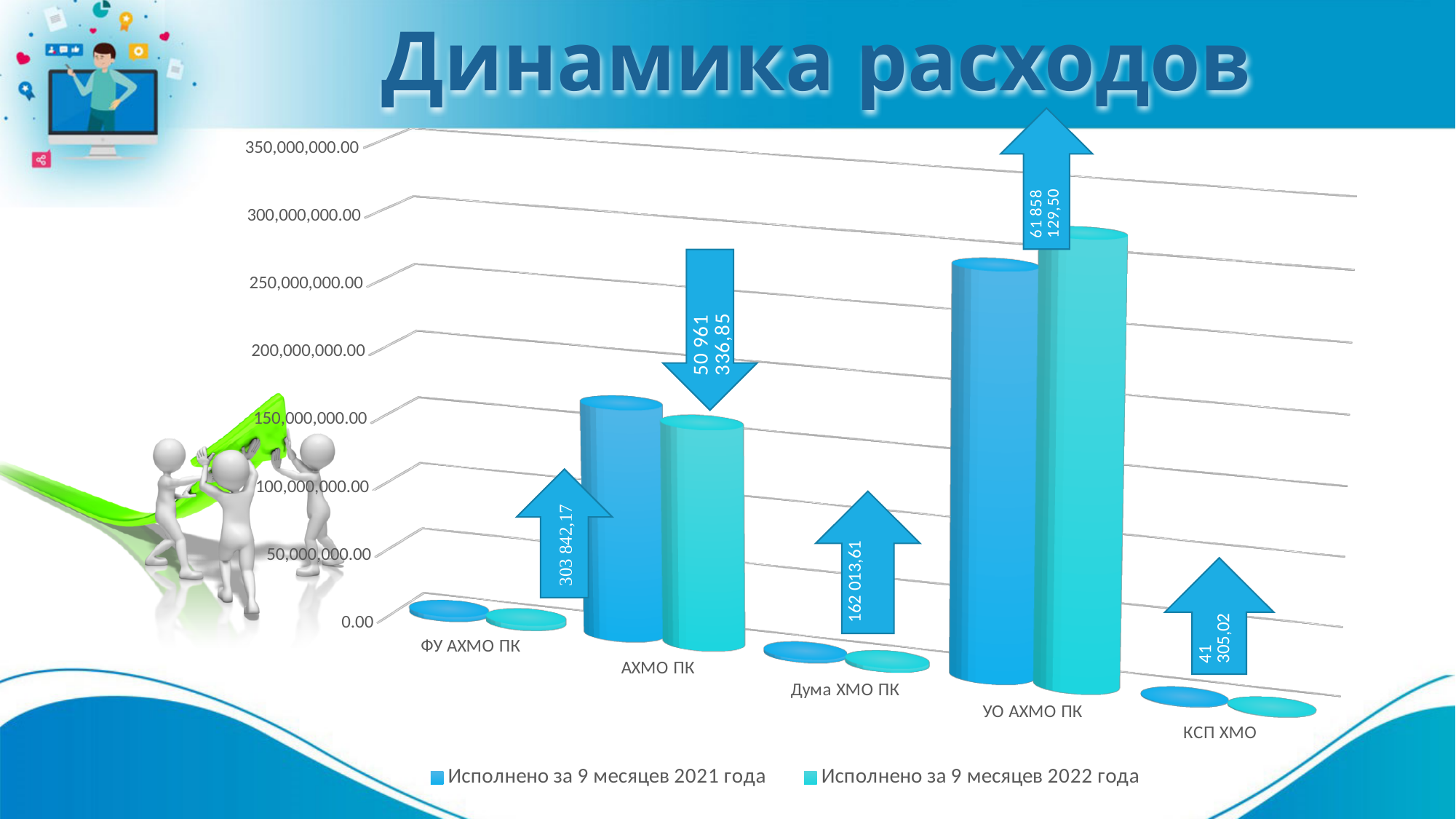
Is the value for УО АХМО ПК in 'Исполнено за 9 месяцев 2021 года' greater or less than 200,000,000.00? greater For УО АХМО ПК, which series has the larger value: 'Исполнено за 9 месяцев 2021 года' or 'Исполнено за 9 месяцев 2022 года'? Исполнено за 9 месяцев 2022 года Is the value for АХМО ПК in 'Исполнено за 9 месяцев 2021 года' greater or less than 100,000,000.00? greater What is the second legend entry of the chart? Исполнено за 9 месяцев 2022 года What is the title of the chart? Динамика расходов Which category has the highest value for 'Исполнено за 9 месяцев 2021 года'? УО АХМО ПК Is the value for КСП ХМО in 'Исполнено за 9 месяцев 2022 года' greater or less than 50,000,000.00? less For АХМО ПК, which series has the larger value: 'Исполнено за 9 месяцев 2021 года' or 'Исполнено за 9 месяцев 2022 года'? Исполнено за 9 месяцев 2021 года What kind of chart is shown on the slide? bar chart How many categories are shown on the x axis of the chart? 5 How many series does the legend list? 2 Which category has the highest value for 'Исполнено за 9 месяцев 2022 года'? УО АХМО ПК